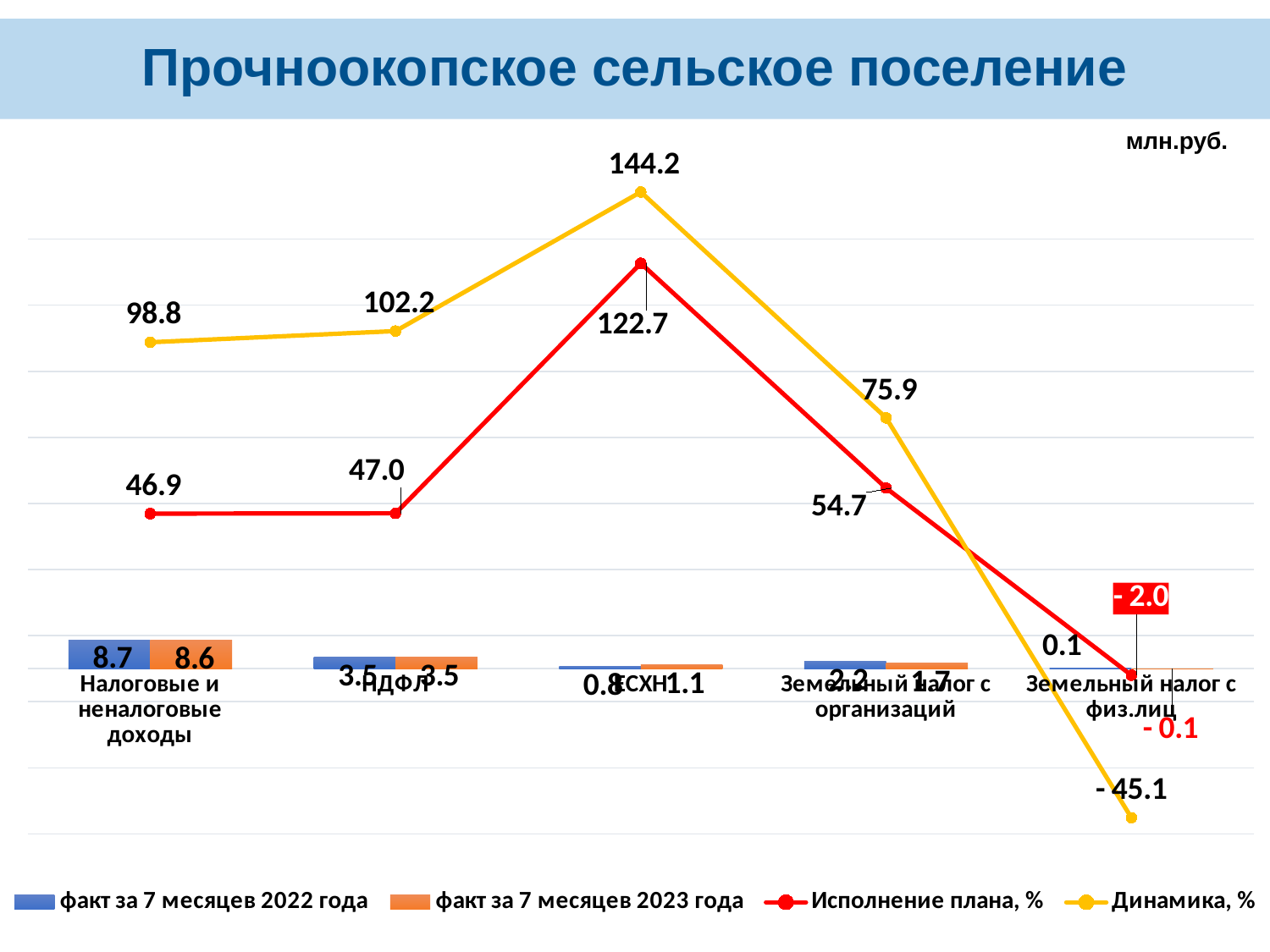
Which category has the highest value of Динамика, %? ЕСХН What unit is indicated in the top right corner of the chart? млн.руб. What is the value of Исполнение плана, % for Земельный налог с организаций? 54.7 What is the value of Динамика, % for ЕСХН? 144.2 What is the value of Динамика, % for Земельный налог с физ.лиц? - 45.1 What is the difference between Динамика, % for ЕСХН and for НДФЛ? 42.0 Which is larger for Земельный налог с организаций: факт за 7 месяцев 2022 года or факт за 7 месяцев 2023 года? факт за 7 месяцев 2022 года Which category has the lowest value of Исполнение плана, %? Земельный налог с физ.лиц How many categories are shown on the x axis? 5 What is the value of Исполнение плана, % for Налоговые и неналоговые доходы? 46.9 How many series does the legend list? 4 What is the value of факт за 7 месяцев 2023 года for Налоговые и неналоговые доходы? 8.6